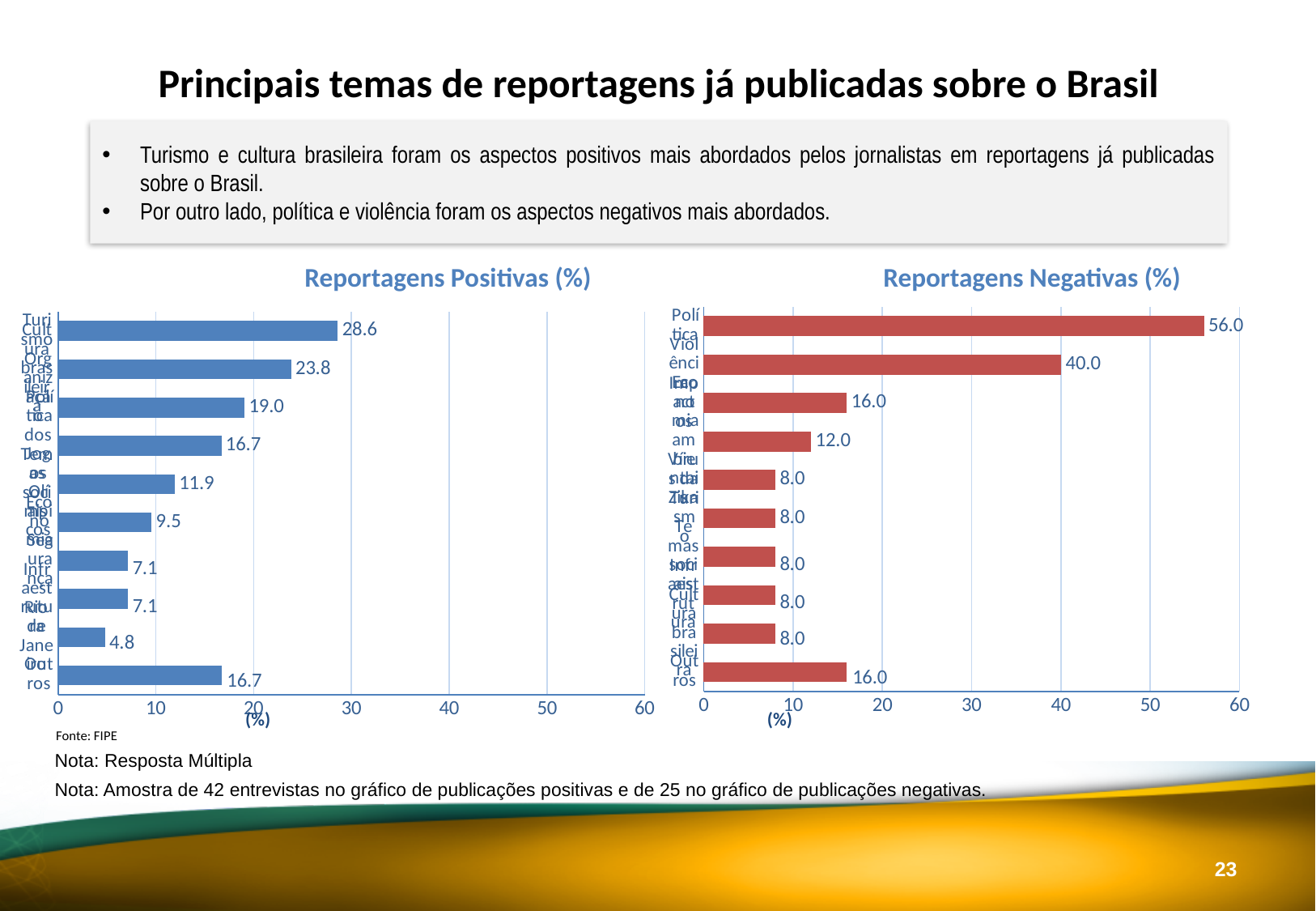
In the Reportagens Negativas (%) chart, is the value for Política greater or less than 50? greater In the Reportagens Positivas (%) chart, what is the value for Turismo? 28.6 Which is larger: the value for Outros in the Reportagens Positivas (%) chart or the value for Outros in the Reportagens Negativas (%) chart? Reportagens Positivas (%) How many bars are plotted in the Reportagens Positivas (%) chart? 10 In the Reportagens Negativas (%) chart, what is the value for Política? 56.0 In the Reportagens Positivas (%) chart, what is the lowest value shown? 4.8 What kind of chart is used for Reportagens Positivas (%)? bar chart In the Reportagens Negativas (%) chart, what is the difference between the values for Política and Violência? 16.0 In the Reportagens Negativas (%) chart, what is the value for Outros? 16.0 In the Reportagens Positivas (%) chart, what is the value for Outros? 16.7 How many bars are plotted in the Reportagens Negativas (%) chart? 10 In the Reportagens Negativas (%) chart, what is the value for Violência? 40.0